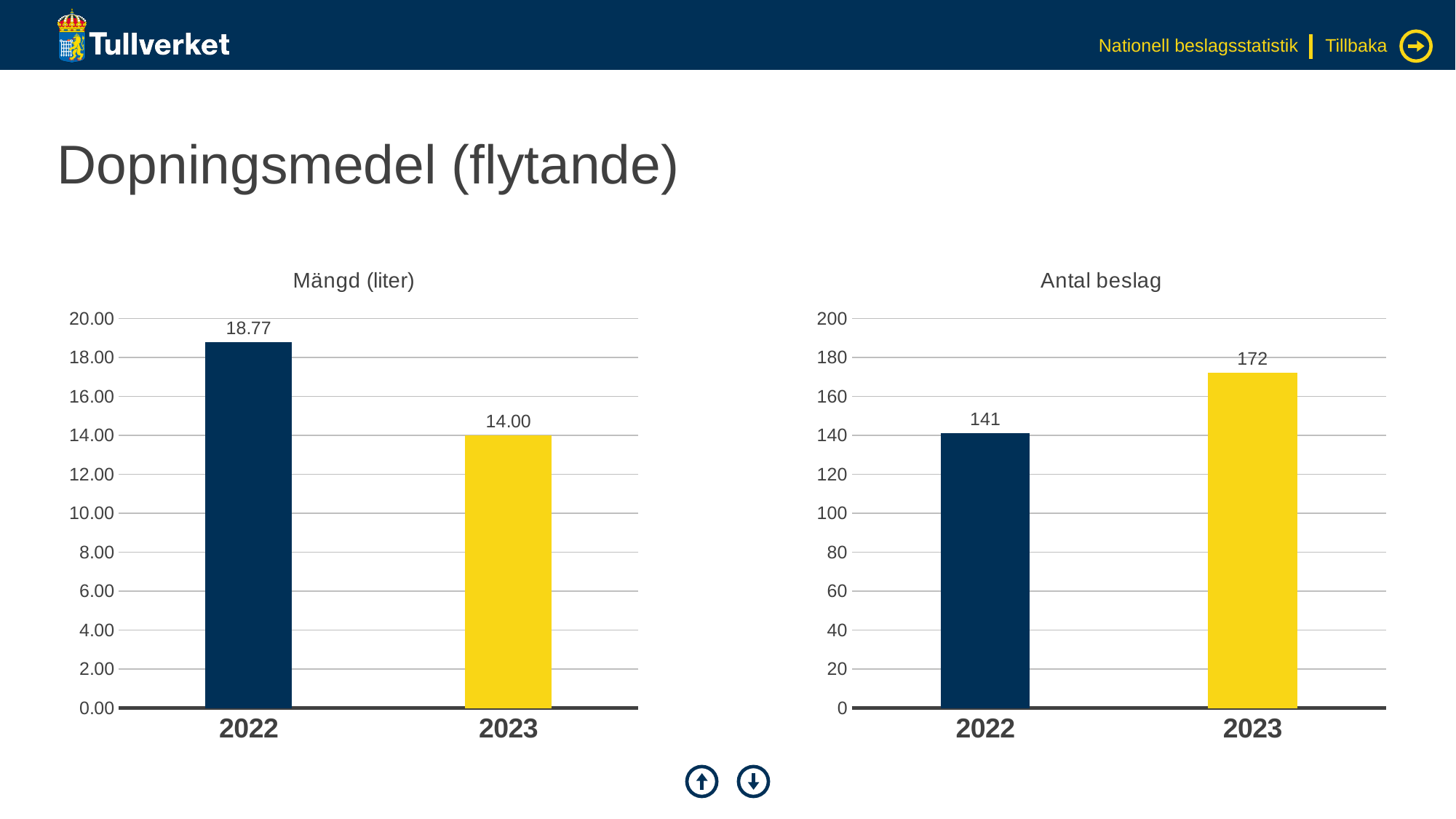
In the 'Antal beslag' chart, do the values rise or fall from 2022 to 2023? rise In the 'Mängd (liter)' chart, what is the difference between the 2022 and 2023 values? 4.77 In the 'Mängd (liter)' chart, how many years are shown on the x axis? 2 In the 'Antal beslag' chart, what is the value for 2022? 141 In the 'Mängd (liter)' chart, which year has the highest value? 2022 What kind of chart is the 'Antal beslag' chart? bar chart In the 'Antal beslag' chart, which year has the lowest value? 2022 In the 'Antal beslag' chart, what is the difference between the 2023 and 2022 values? 31 In the 'Mängd (liter)' chart, what is the value for 2022? 18.77 In the 'Antal beslag' chart, is the value for 2023 greater or less than 160? greater In the 'Mängd (liter)' chart, what is the value for 2023? 14.00 In the 'Antal beslag' chart, what is the value for 2023? 172